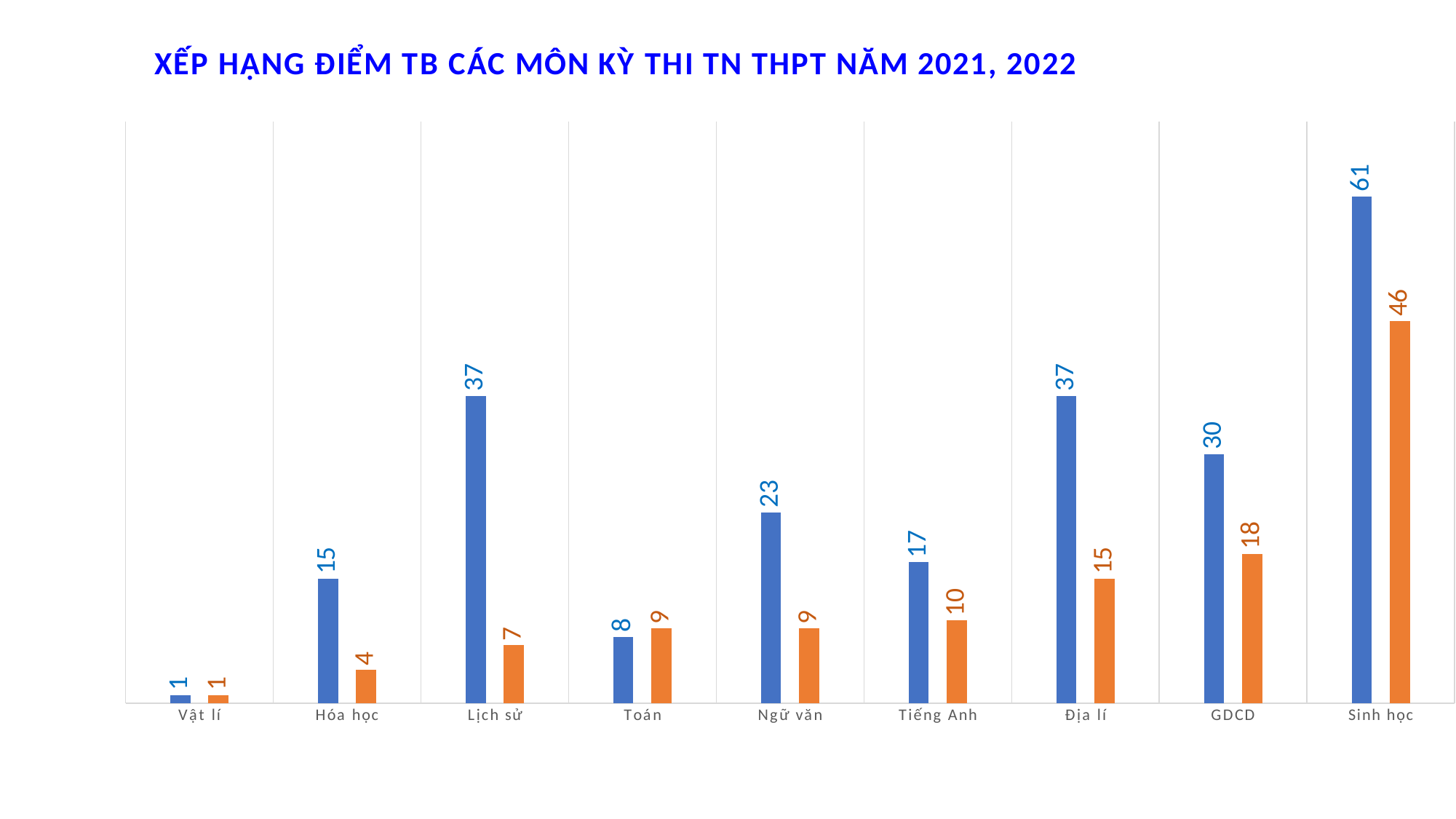
What is the difference between the blue and orange bars for Địa lí? 22 Which category has the highest blue bar? Sinh học What type of chart is shown on the slide? bar chart What is the difference between the blue bar for Sinh học and the blue bar for GDCD? 31 What is the value of the orange bar for Lịch sử? 7 How many categories are shown on the x axis? 9 For Toán, which bar is larger, the blue or the orange? orange What is the value of the orange bar for GDCD? 18 Which category has the lowest orange bar? Vật lí What is the value of the blue bar for Sinh học? 61 Which is larger, the blue bar for Hóa học or the blue bar for Tiếng Anh? Tiếng Anh What is the value of the blue bar for Ngữ văn? 23